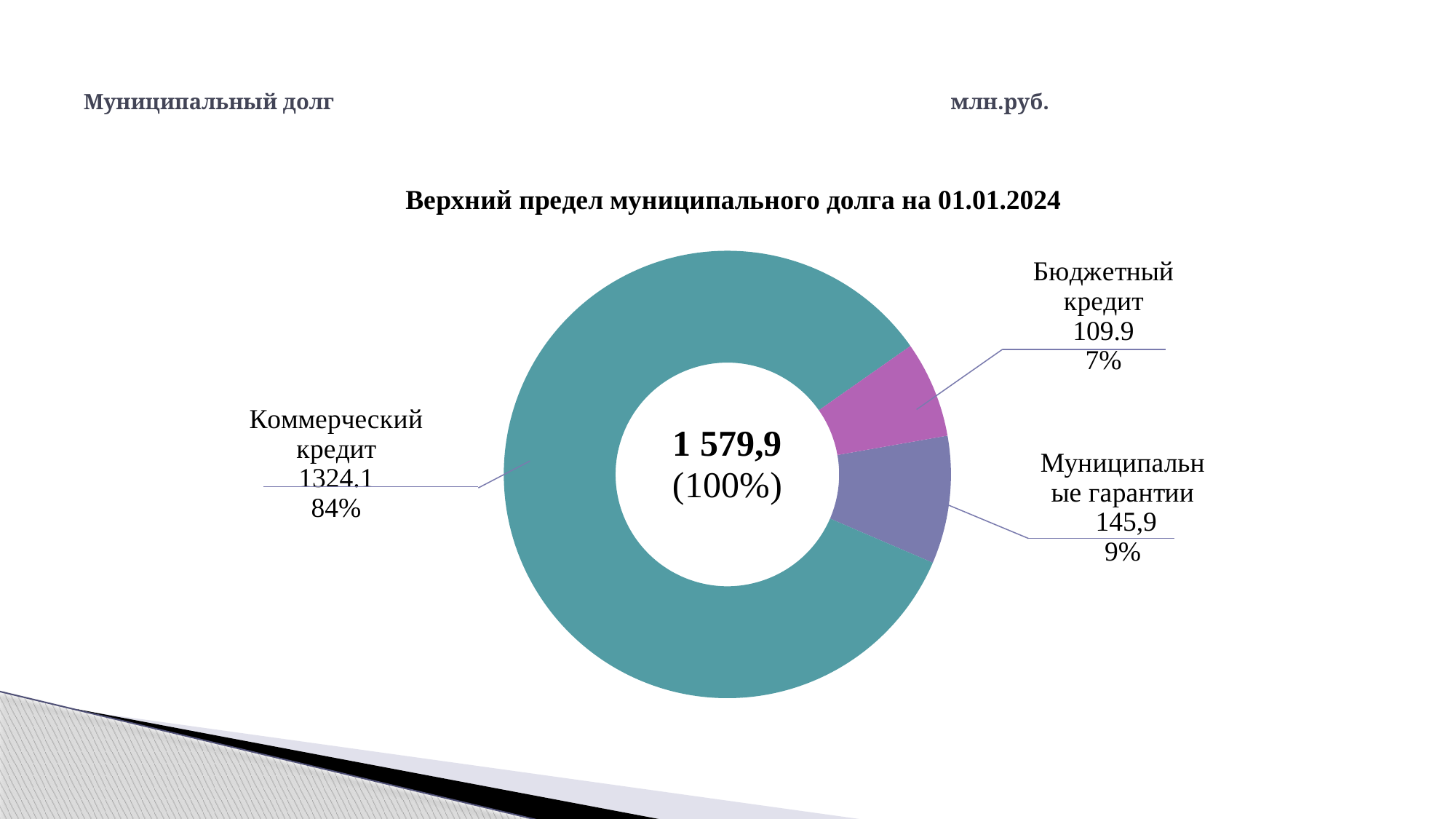
What is the difference between Коммерческий кредит and Бюджетный кредит? 1214.2 How many categories does the chart show? 3 Which category has the smallest share of the municipal debt? Бюджетный кредит What is the value for Муниципальные гарантии? 145,9 What is the value for Коммерческий кредит? 1324.1 What share of the total does Муниципальные гарантии represent? 9% Which is larger, Муниципальные гарантии or Бюджетный кредит? Муниципальные гарантии What type of chart is shown on the slide? Donut (pie) chart What is the value for Бюджетный кредит? 109.9 What share of the total does Коммерческий кредит represent? 84% Which category has the largest share of the municipal debt? Коммерческий кредит What total is shown in the centre of the donut chart? 1 579,9